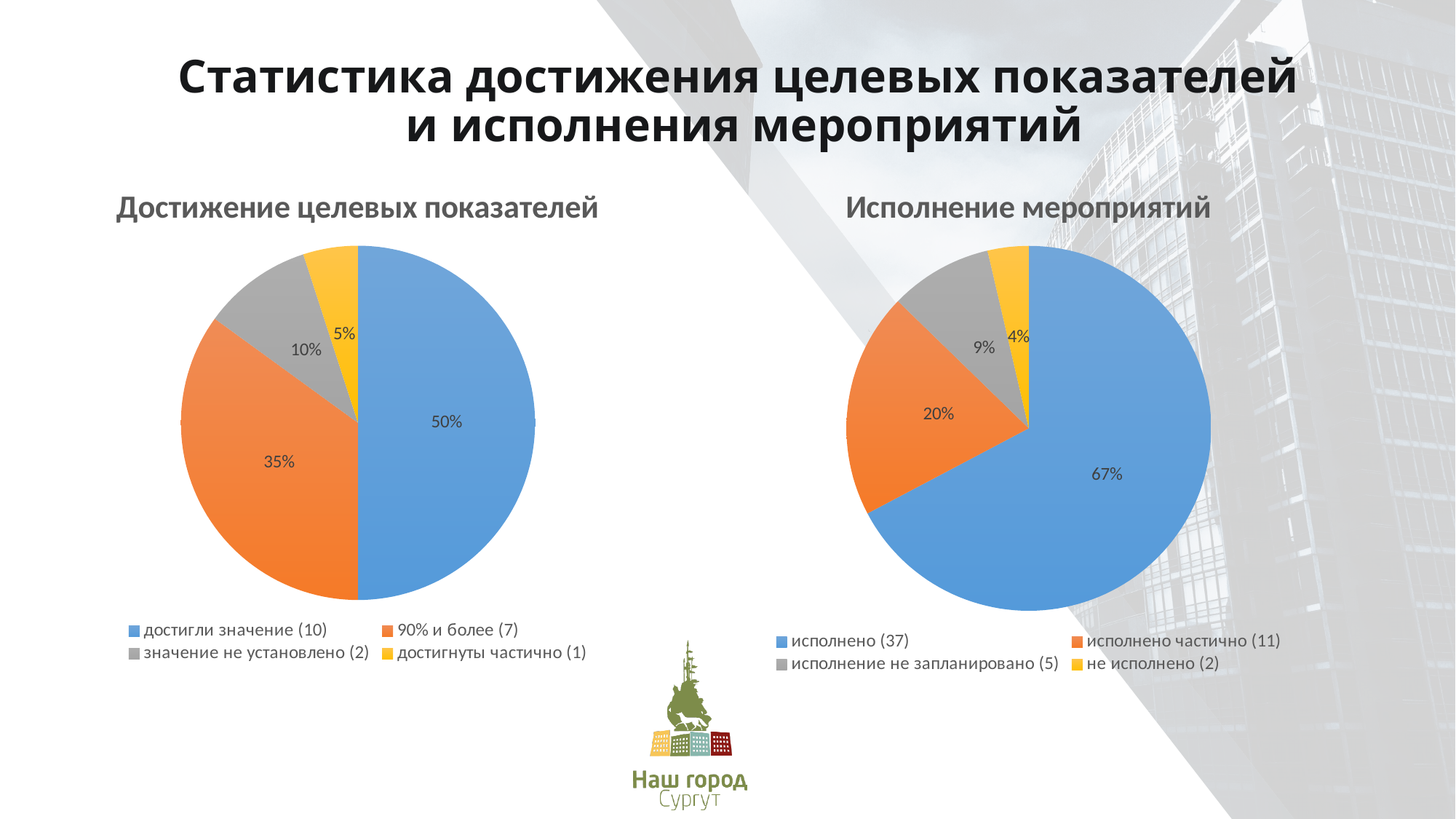
In the chart 'Достижение целевых показателей', what colour is the slice for 'значение не установлено (2)'? Grey In the chart 'Исполнение мероприятий', what share of the pie is 'исполнено (37)'? 67% In the chart 'Достижение целевых показателей', what share of the pie is 'достигли значение (10)'? 50% In the chart 'Достижение целевых показателей', which category has the smallest slice? достигнуты частично (1) In the chart 'Достижение целевых показателей', how many slices does the pie have? 4 In the chart 'Достижение целевых показателей', what share of the pie is '90% и более (7)'? 35% In the chart 'Исполнение мероприятий', which is larger: 'исполнено частично (11)' or 'не исполнено (2)'? исполнено частично (11) In the chart 'Достижение целевых показателей', what is the difference in percentage points between 'достигли значение (10)' and '90% и более (7)'? 15 In the chart 'Исполнение мероприятий', what is the difference in percentage points between 'исполнено (37)' and 'исполнено частично (11)'? 47 What type of chart is 'Исполнение мероприятий'? Pie chart In the chart 'Исполнение мероприятий', which category has the largest slice? исполнено (37)